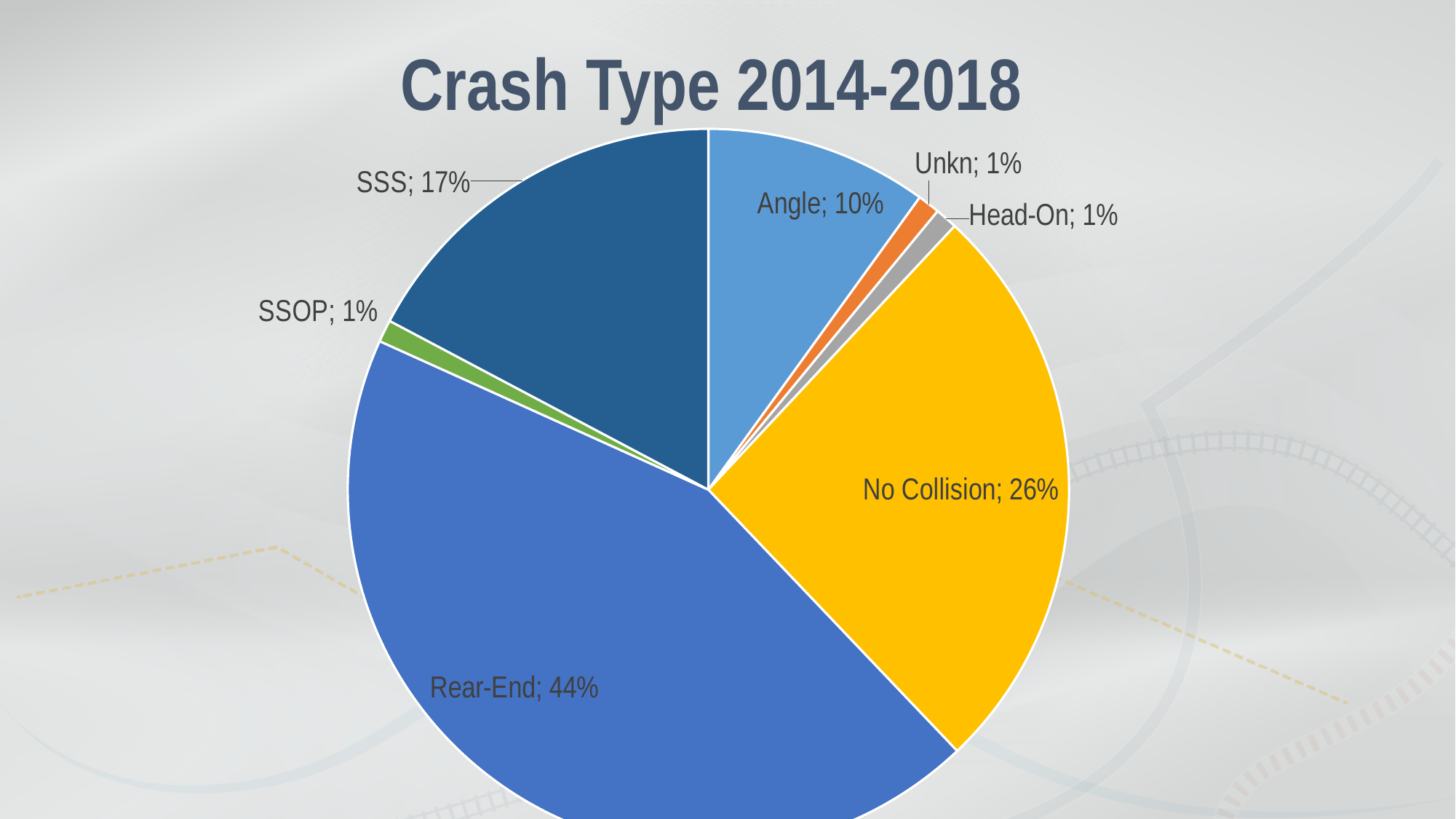
How many slices does the pie chart have? 7 What kind of chart is shown on the slide? Pie chart What share of crashes is SSS? 17% Which crash type has the larger share, No Collision or SSS? No Collision What is the title of the chart? Crash Type 2014-2018 What share of crashes is Rear-End? 44% What share of crashes is Angle? 10% What is the difference in percentage points between SSS and Angle? 7 Which crash type has the largest share? Rear-End What is the difference in percentage points between Rear-End and No Collision? 18 What colour is the No Collision slice? Yellow What share of crashes is No Collision? 26%